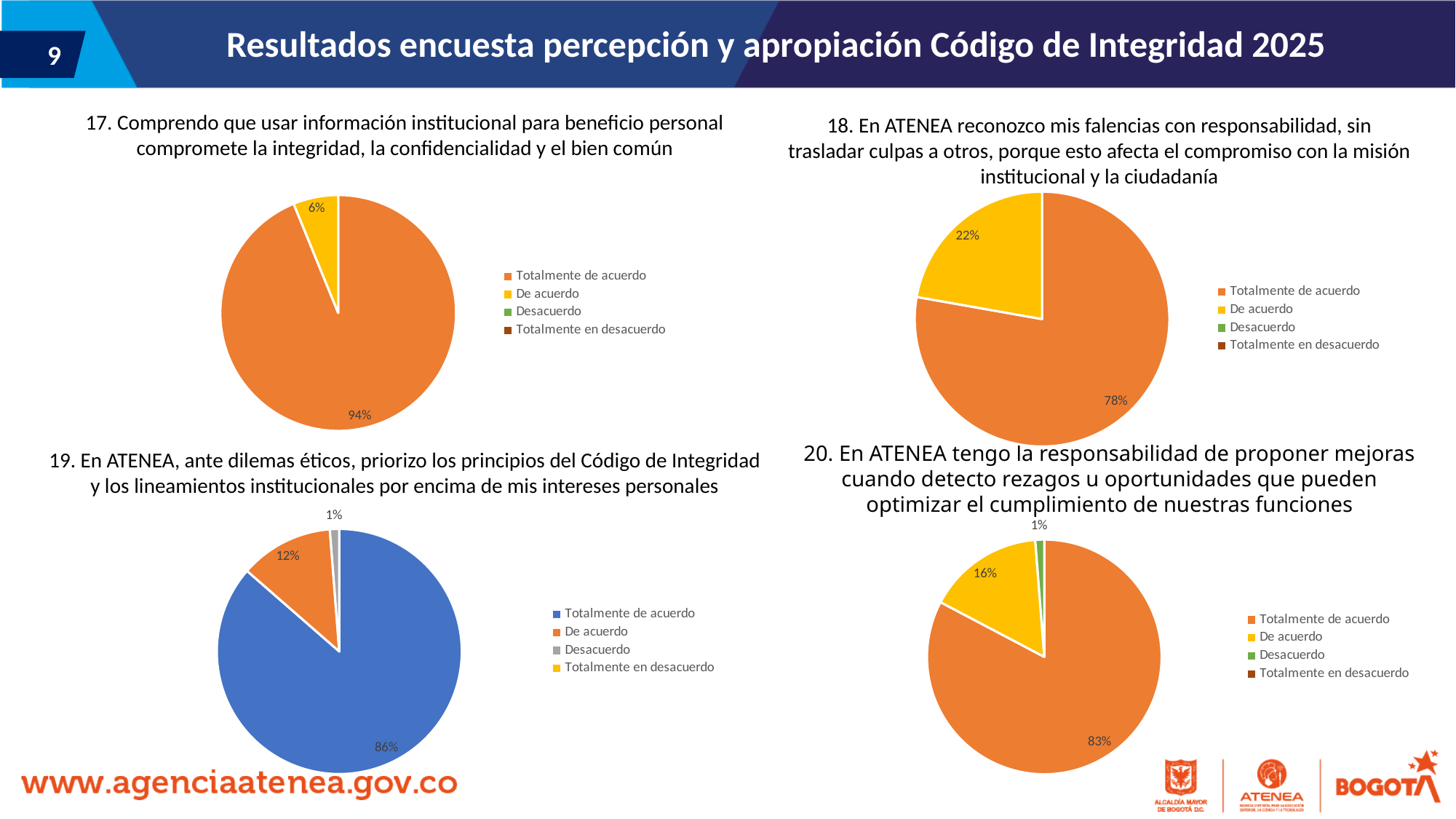
In the pie chart for question 18, what percentage is shown for 'Totalmente de acuerdo'? 78% In the pie chart for question 17, what percentage is shown for 'Totalmente de acuerdo'? 94% In the pie chart for question 20, what percentage is shown for 'De acuerdo'? 16% How many entries does the legend of the pie chart for question 19 list? 4 In the pie chart for question 18, what percentage is shown for 'De acuerdo'? 22% Which is larger: the 'De acuerdo' share in the chart for question 17 or in the chart for question 18? Question 18 In the pie chart for question 17, what percentage is shown for 'De acuerdo'? 6% In the pie chart for question 19, what percentage is shown for 'Totalmente de acuerdo'? 86% In the pie chart for question 19, what percentage is shown for 'De acuerdo'? 12% In the pie chart for question 18, what is the difference between the 'Totalmente de acuerdo' and 'De acuerdo' percentages? 56% What type of chart is used for question 20? Pie chart In the pie chart for question 20, which category has the largest slice? Totalmente de acuerdo